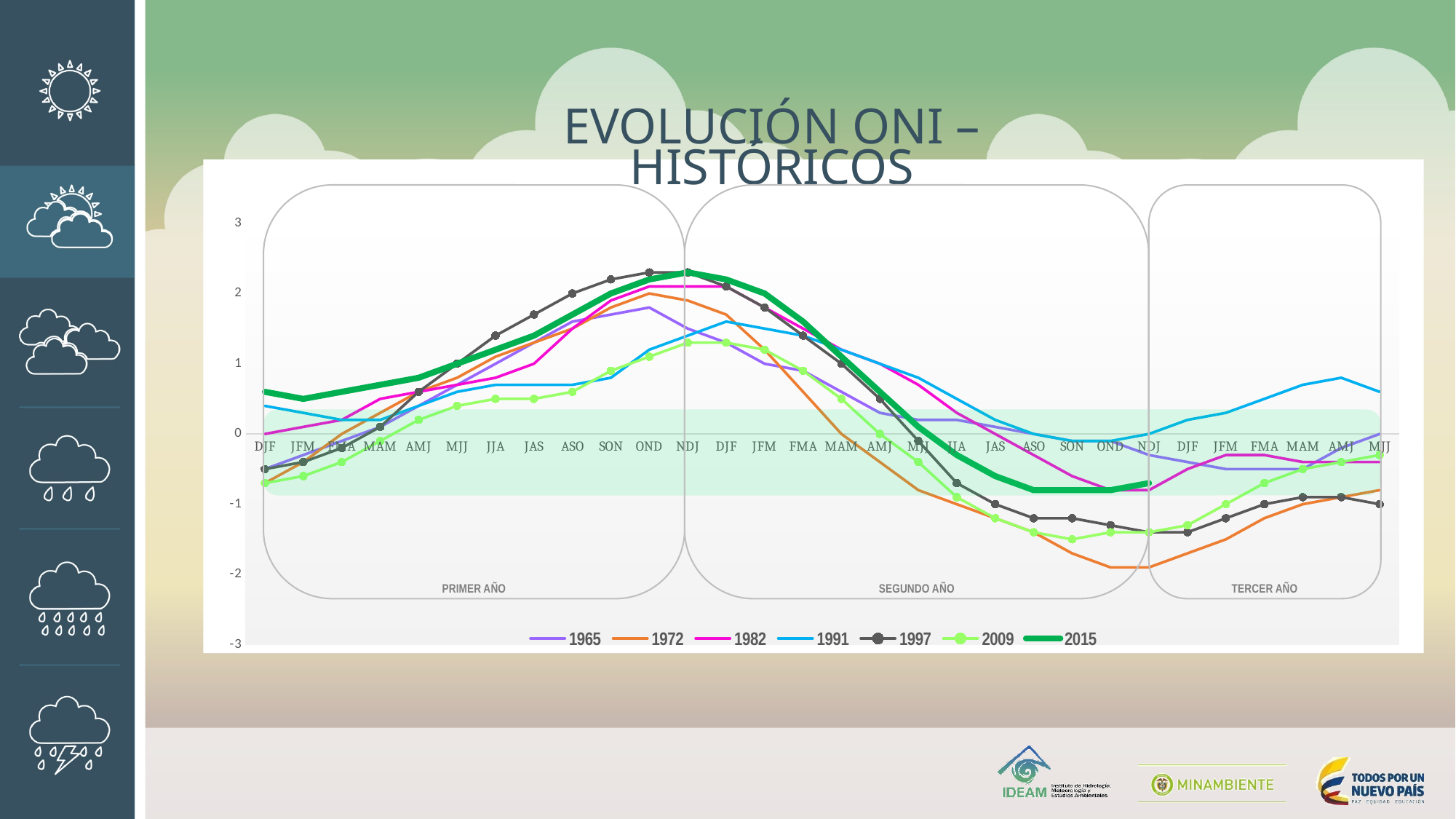
Is the value for the 1972 series at OND of the second year greater or less than -1? less Is the value for the 2009 series at NDJ of the first year greater or less than 1? greater Is the value for the 1997 series at NDJ of the first year greater or less than 2? greater How many series does the legend list? 7 Which series reaches the lowest value anywhere on the chart? 1972 What are the labels of the three panels along the bottom of the chart? PRIMER AÑO, SEGUNDO AÑO, TERCER AÑO What kind of chart is shown on the slide? line chart Does the 1997 series rise or fall from NDJ of the first year to NDJ of the second year? fall At OND of the second year, which series has the larger value, 1972 or 1991? 1991 What is the title of the chart? EVOLUCIÓN ONI – HISTÓRICOS At NDJ of the first year, which series has the larger value, 1997 or 2009? 1997